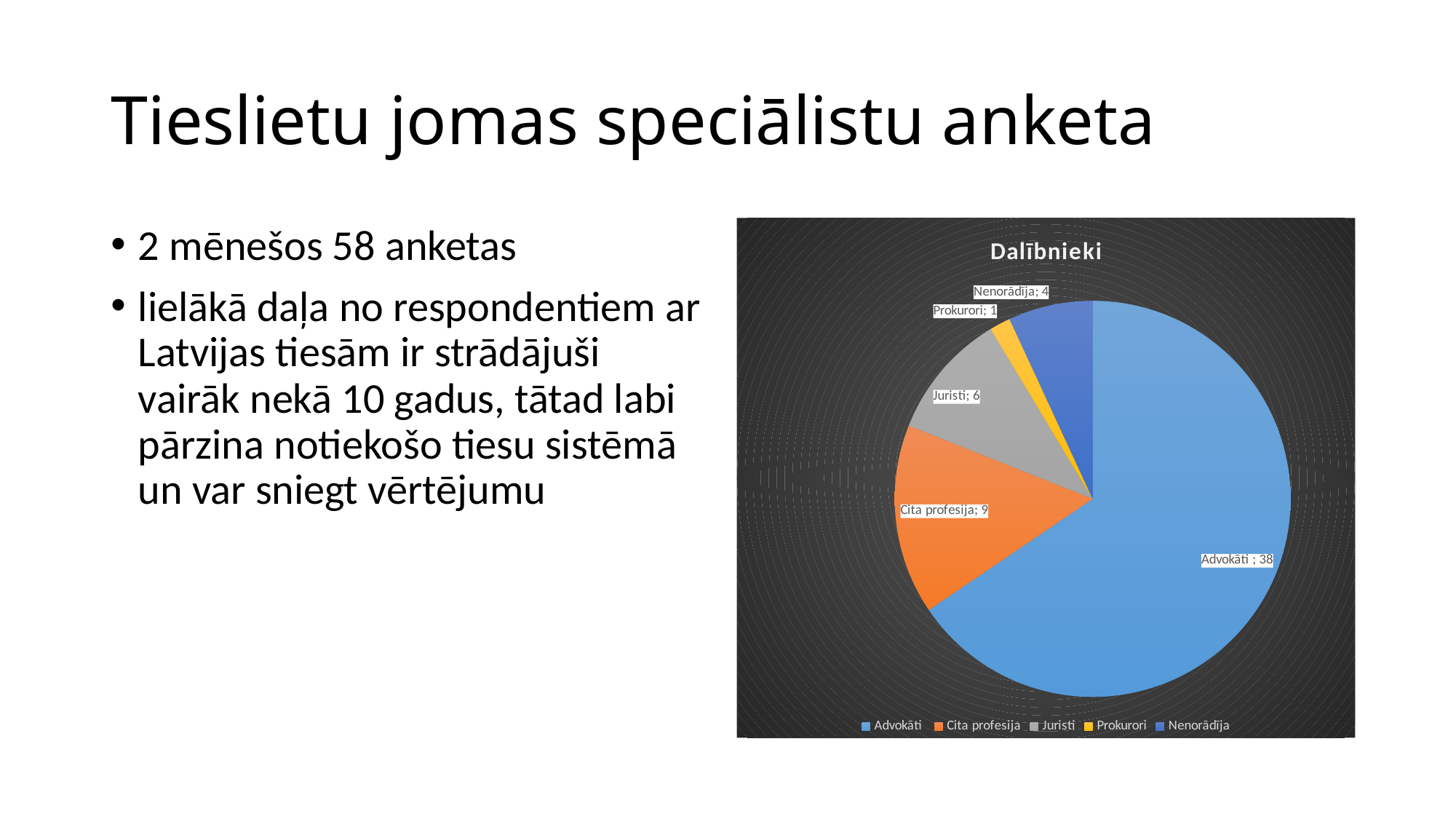
What is the value for Prokurori in the pie chart? 1 What is the title of the chart? Dalībnieki What is the value for Cita profesija in the pie chart? 9 How many categories does the pie chart show? 5 Which category has the largest slice in the pie chart? Advokāti What is the value for Nenorādīja in the pie chart? 4 What is the difference between the values for Advokāti and Cita profesija? 29 Which is larger, the value for Juristi or the value for Nenorādīja? Juristi What is the value for Advokāti in the pie chart? 38 Which category has the smallest slice in the pie chart? Prokurori What type of chart is shown on the slide? pie chart What is the value for Juristi in the pie chart? 6